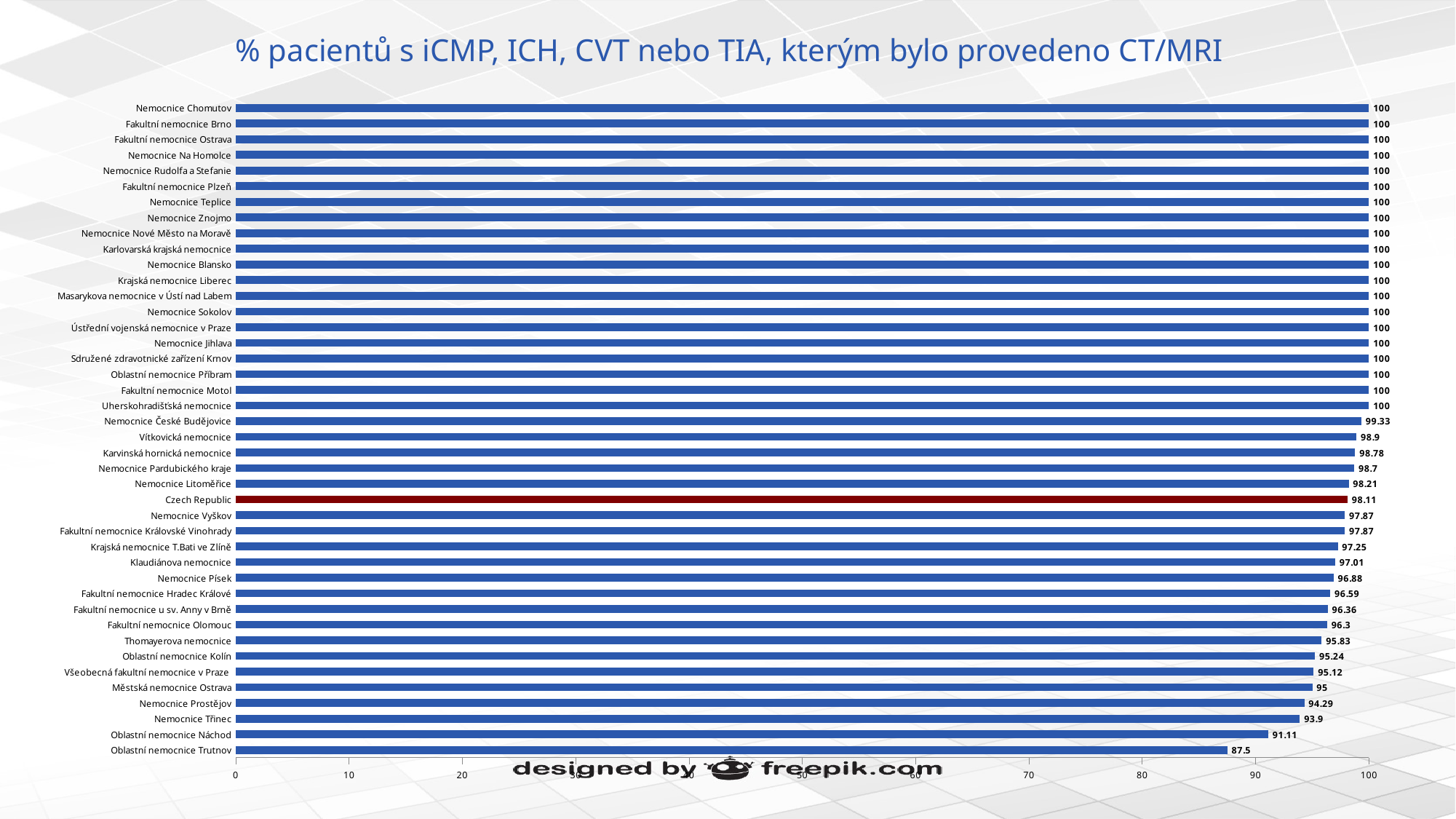
What kind of chart is shown on the slide? bar chart What is the value for Fakultní nemocnice Olomouc? 96.3 What is the value for Czech Republic? 98.11 What is the difference between the values for Oblastní nemocnice Náchod and Oblastní nemocnice Trutnov? 3.61 What is the value for Oblastní nemocnice Trutnov? 87.5 How many categories are shown in the chart? 42 Which category has the lowest value? Oblastní nemocnice Trutnov What is the difference between the values for Nemocnice Chomutov and Czech Republic? 1.89 Is the value for Oblastní nemocnice Trutnov greater or less than 90? less What is the value for Nemocnice České Budějovice? 99.33 Which bar is highlighted in a different colour (dark red) from the others? Czech Republic Which is larger, the value for Nemocnice Třinec or the value for Nemocnice Prostějov? Nemocnice Prostějov